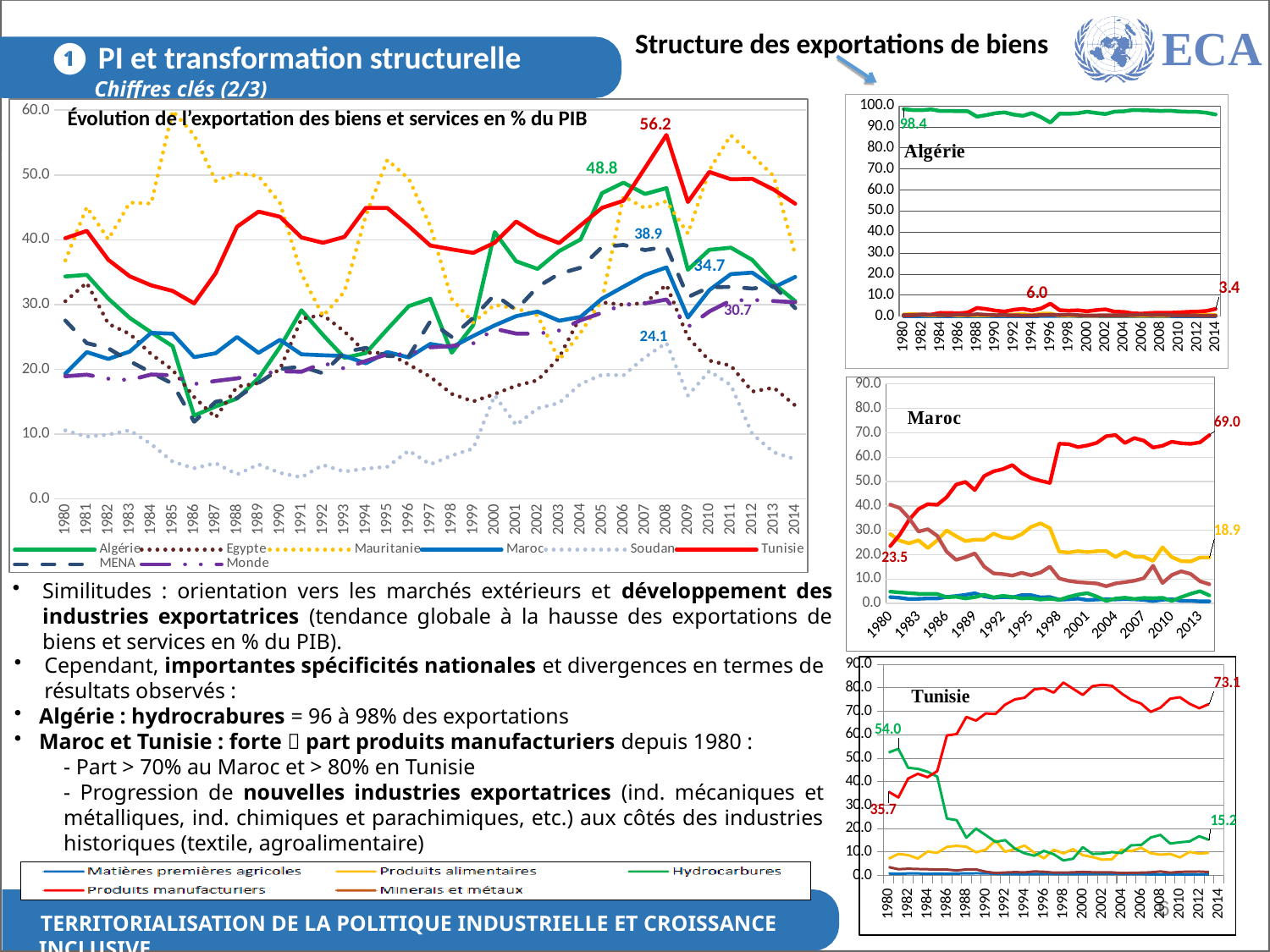
What kind of chart is the chart titled 'Évolution de l'exportation des biens et services en % du PIB'? Line chart In the chart 'Évolution de l'exportation des biens et services en % du PIB', what is the difference between the labelled Tunisie value (56.2) and the labelled Algérie value (48.8)? 7.4 In the Tunisie chart on the right, which is larger in 2014: Produits manufacturiers or Hydrocarbures? Produits manufacturiers In the chart 'Évolution de l'exportation des biens et services en % du PIB', what value is labelled on the Soudan line? 24.1 In the Algérie chart on the right, what value is labelled for Hydrocarbures in 1980? 98.4 In the Maroc chart on the right, by how much did Produits manufacturiers increase from 1980 (23.5) to 2014 (69.0)? 45.5 In the chart 'Évolution de l'exportation des biens et services en % du PIB', what is the peak value labelled on the Tunisie line? 56.2 In the Algérie chart on the right, is the Hydrocarbures value in 2014 greater or less than 90.0? greater In the Tunisie chart on the right, does the Hydrocarbures line rise or fall from 1980 to 2014? Fall In the chart 'Évolution de l'exportation des biens et services en % du PIB', what value is labelled on the Algérie line? 48.8 In the Maroc chart on the right, what value is labelled for Produits manufacturiers in 2014? 69.0 How many series does the legend of the chart 'Évolution de l'exportation des biens et services en % du PIB' list? 8